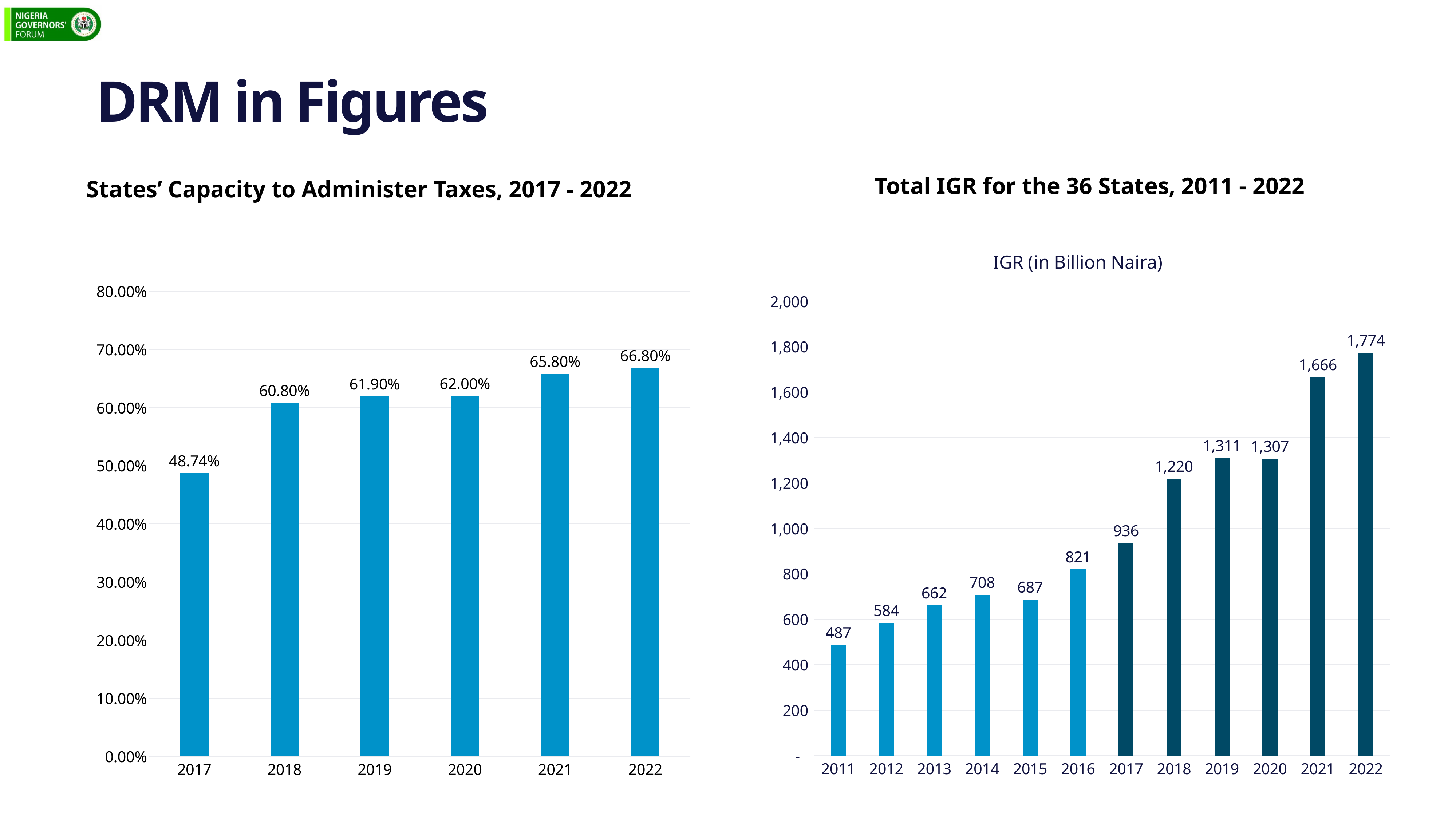
In the 'Total IGR for the 36 States, 2011 - 2022' chart, what unit is given in the chart's inner title? Billion Naira In the 'States' Capacity to Administer Taxes, 2017 - 2022' chart, what is the difference between the 2022 and 2017 values? 18.06% In the 'Total IGR for the 36 States, 2011 - 2022' chart, what is the IGR value for 2016? 821 In the 'States' Capacity to Administer Taxes, 2017 - 2022' chart, how many years are shown on the x axis? 6 What kind of chart is the 'Total IGR for the 36 States, 2011 - 2022' chart? bar chart In the 'Total IGR for the 36 States, 2011 - 2022' chart, what is the difference between the 2022 and 2021 values? 108 In the 'Total IGR for the 36 States, 2011 - 2022' chart, which year has the lowest IGR? 2011 In the 'States' Capacity to Administer Taxes, 2017 - 2022' chart, what is the value for 2017? 48.74% In the 'Total IGR for the 36 States, 2011 - 2022' chart, how many years are shown on the x axis? 12 In the 'States' Capacity to Administer Taxes, 2017 - 2022' chart, which year has the highest value? 2022 In the 'Total IGR for the 36 States, 2011 - 2022' chart, which is larger, the value for 2014 or the value for 2015? 2014 In the 'States' Capacity to Administer Taxes, 2017 - 2022' chart, do the values generally rise or fall from 2017 to 2022? rise